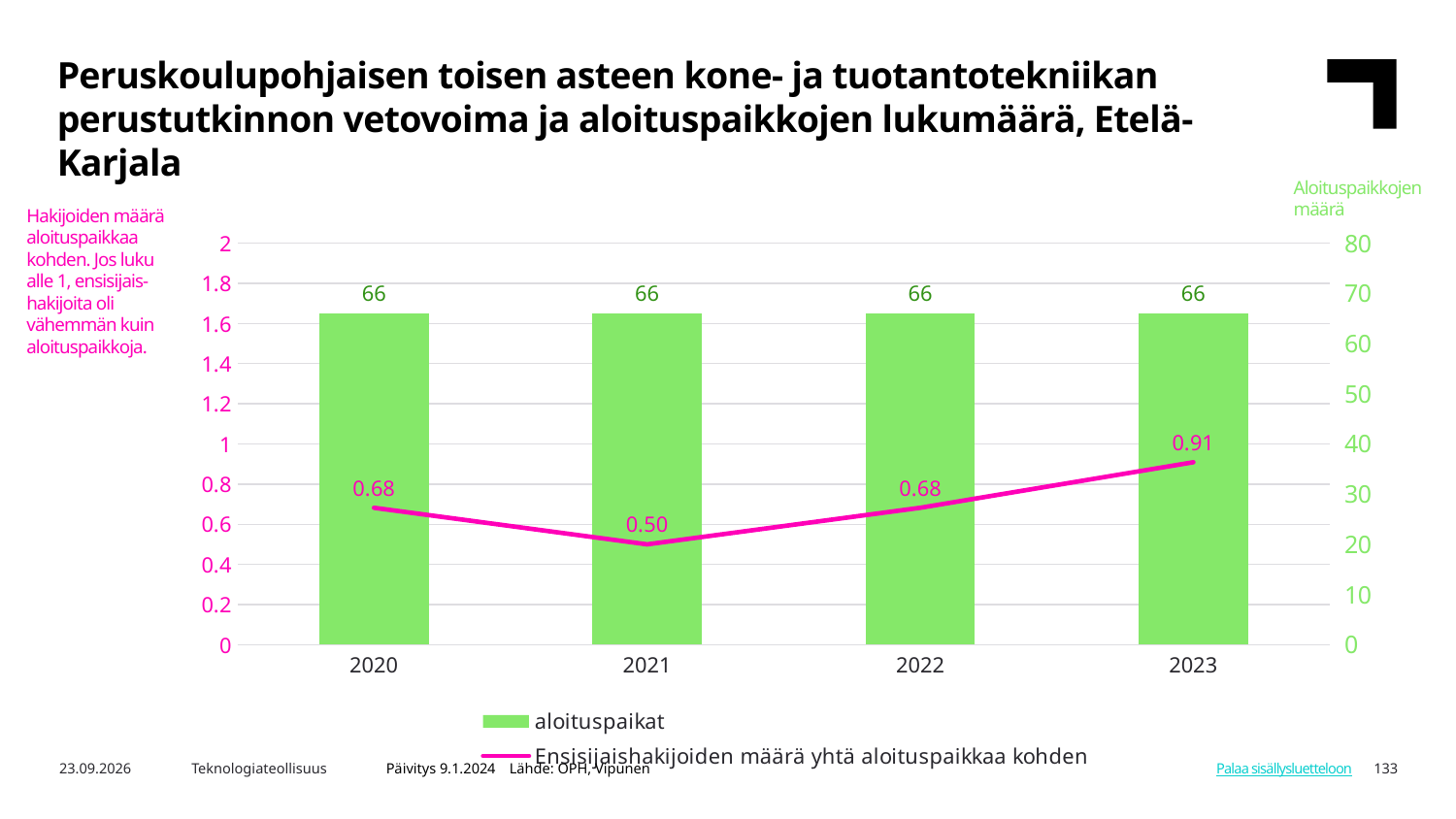
What is the value of Ensisijaishakijoiden määrä yhtä aloituspaikkaa kohden for 2021? 0.50 How many series does the legend list? 2 What is the value of aloituspaikat for 2021? 66 Which is larger, the Ensisijaishakijoiden määrä yhtä aloituspaikkaa kohden value for 2022 or for 2021? 2022 In which year is Ensisijaishakijoiden määrä yhtä aloituspaikkaa kohden highest? 2023 In which year is Ensisijaishakijoiden määrä yhtä aloituspaikkaa kohden lowest? 2021 What is the difference between the Ensisijaishakijoiden määrä yhtä aloituspaikkaa kohden values for 2023 and 2021? 0.41 What colour are the aloituspaikat bars? green How many years are shown on the x axis? 4 Is the value of Ensisijaishakijoiden määrä yhtä aloituspaikkaa kohden for 2023 greater or less than 1? less Does the Ensisijaishakijoiden määrä yhtä aloituspaikkaa kohden line rise or fall from 2021 to 2023? rise What is the value of Ensisijaishakijoiden määrä yhtä aloituspaikkaa kohden for 2023? 0.91